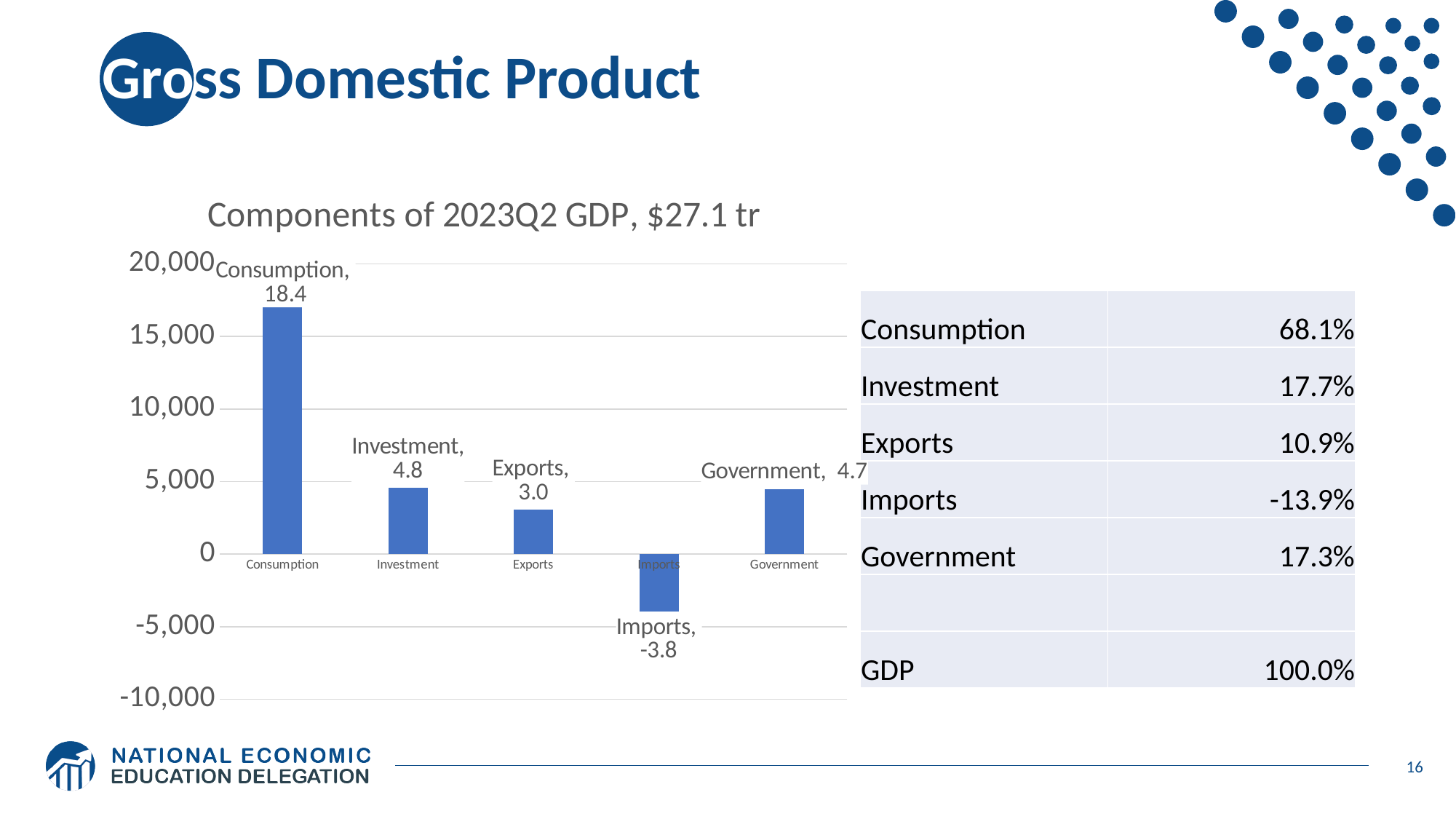
Which category has the highest value in the chart? Consumption What is the difference between the labelled values for Consumption and Investment? 13.6 What kind of chart is shown on the slide? bar chart Which category has the lowest value in the chart? Imports Which is larger, the value for Investment or the value for Exports? Investment What is the data label value for Government in the chart? 4.7 How many categories are shown on the x axis of the chart? 5 What is the data label value for Consumption in the chart? 18.4 What is the data label value for Imports in the chart? -3.8 Is the bar for Consumption greater or less than 15,000 on the axis? greater What is the title of the chart? Components of 2023Q2 GDP, $27.1 tr What is the data label value for Exports in the chart? 3.0